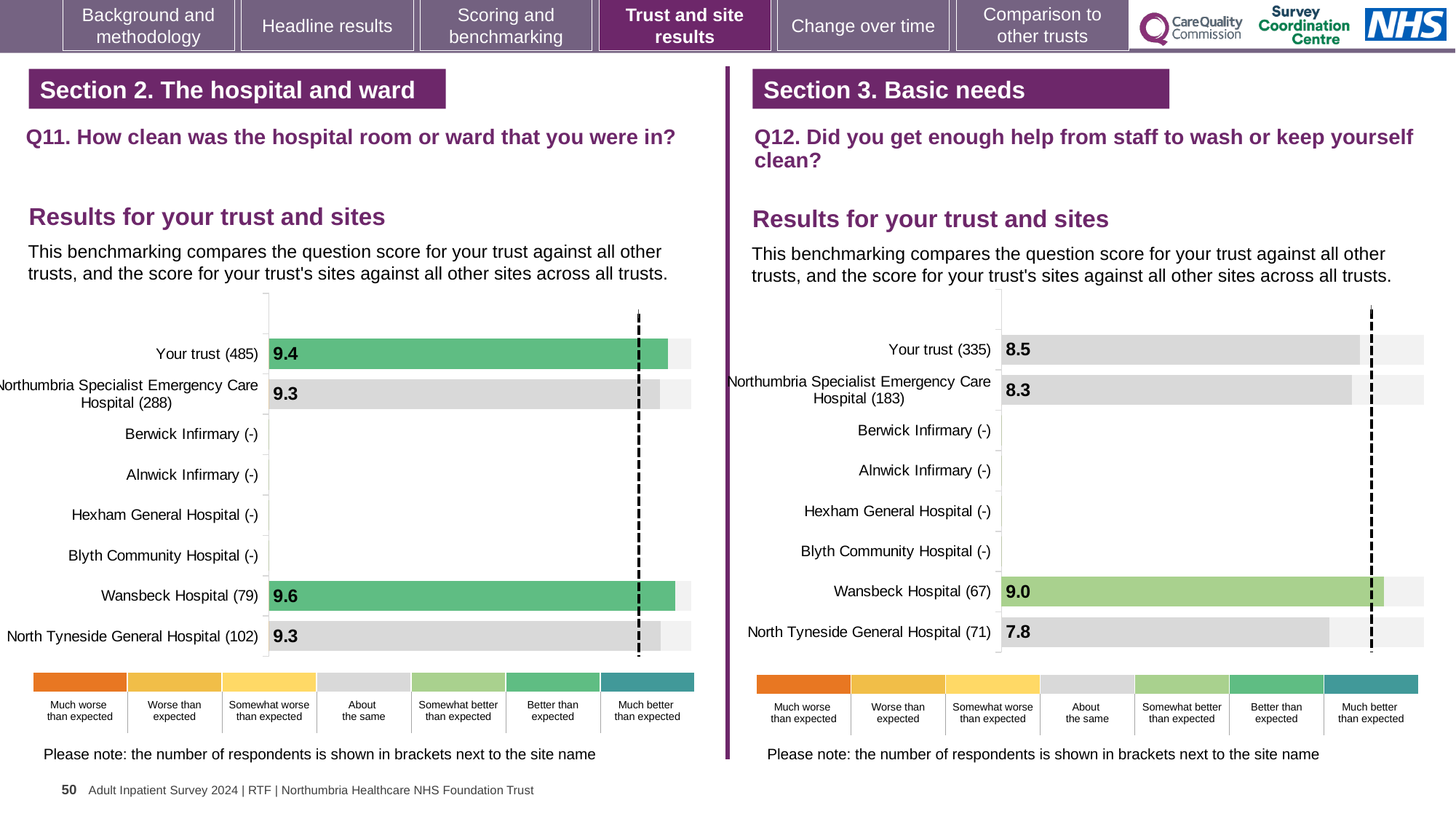
On the Q12 chart (right), which is larger: the score for Wansbeck Hospital (67) or Northumbria Specialist Emergency Care Hospital (183)? Wansbeck Hospital (67) On the Q12 chart (right), how many categories in the legend describe the benchmarking bands? 7 What type of chart is used on the Q12 chart (right)? Bar chart On the Q12 chart (right), which site or trust row has the lowest score? North Tyneside General Hospital (71) On the Q11 chart (left), what is the score for Your trust (485)? 9.4 On the Q12 chart (right), what is the score for Your trust (335)? 8.5 On the Q11 chart (left), how many rows have a score value displayed? 4 On the Q11 chart (left), what is the difference between the scores for Wansbeck Hospital (79) and North Tyneside General Hospital (102)? 0.3 On the Q12 chart (right), what is the score for North Tyneside General Hospital (71)? 7.8 On the Q11 chart (left), which site or trust row has the highest score? Wansbeck Hospital (79) On the Q11 chart (left), what is the score for Wansbeck Hospital (79)? 9.6 On the Q12 chart (right), what is the difference between the scores for Your trust (335) and North Tyneside General Hospital (71)? 0.7